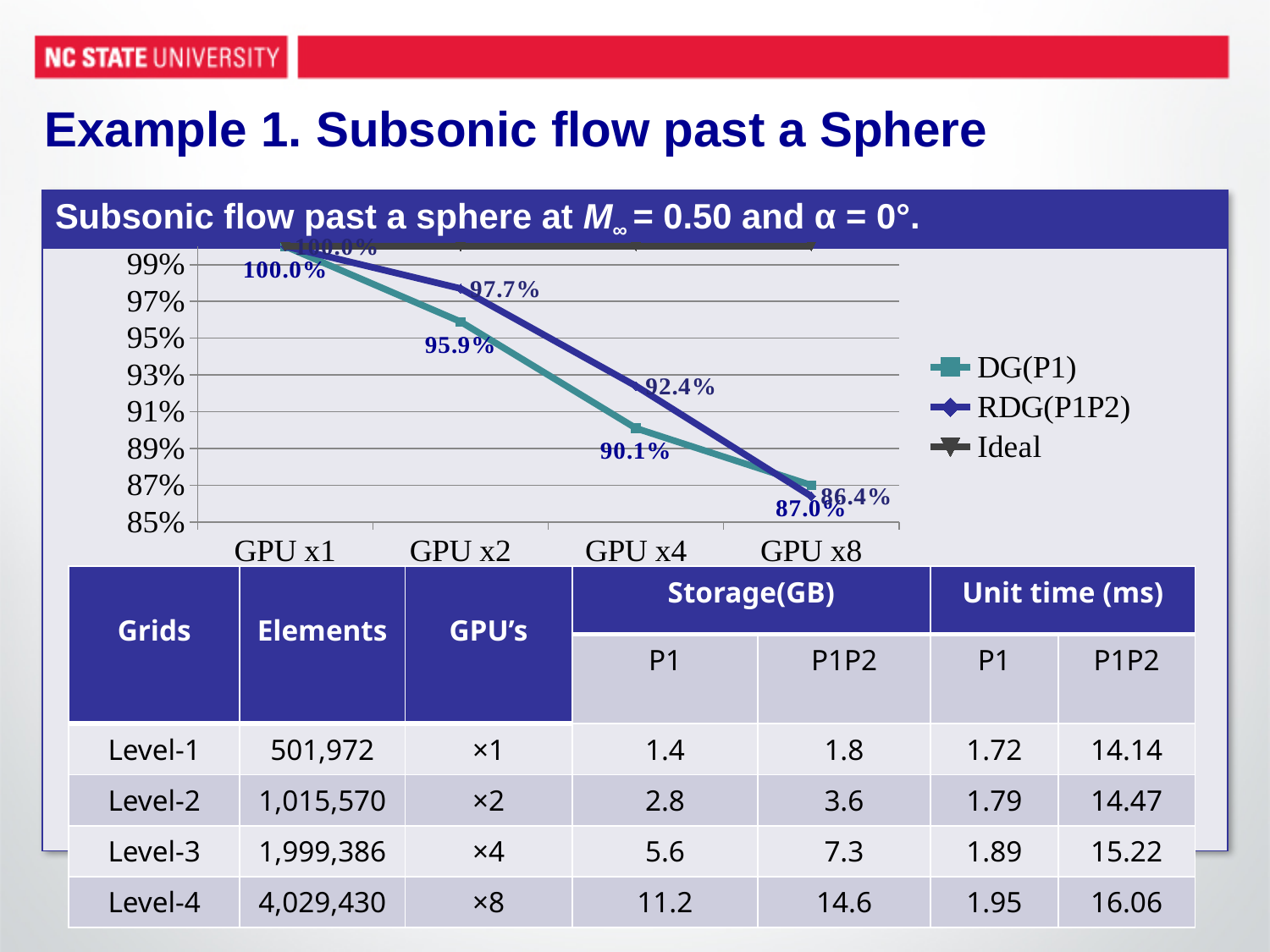
At which GPU category is the DG(P1) value lowest? GPU x8 What is the value of DG(P1) at GPU x2? 95.9% What is the value of RDG(P1P2) at GPU x2? 97.7% Do the DG(P1) values rise or fall as the number of GPUs increases along the x axis? fall Which series in the legend is drawn in teal? DG(P1) What is the value of RDG(P1P2) at GPU x4? 92.4% What is the value of DG(P1) at GPU x4? 90.1% What is the difference between the RDG(P1P2) and DG(P1) values at GPU x2? 1.8% How many GPU categories are shown on the x axis of the chart? 4 Which series has the larger value at GPU x4, DG(P1) or RDG(P1P2)? RDG(P1P2) What type of chart is shown on the slide? line chart How many series does the chart legend list? 3